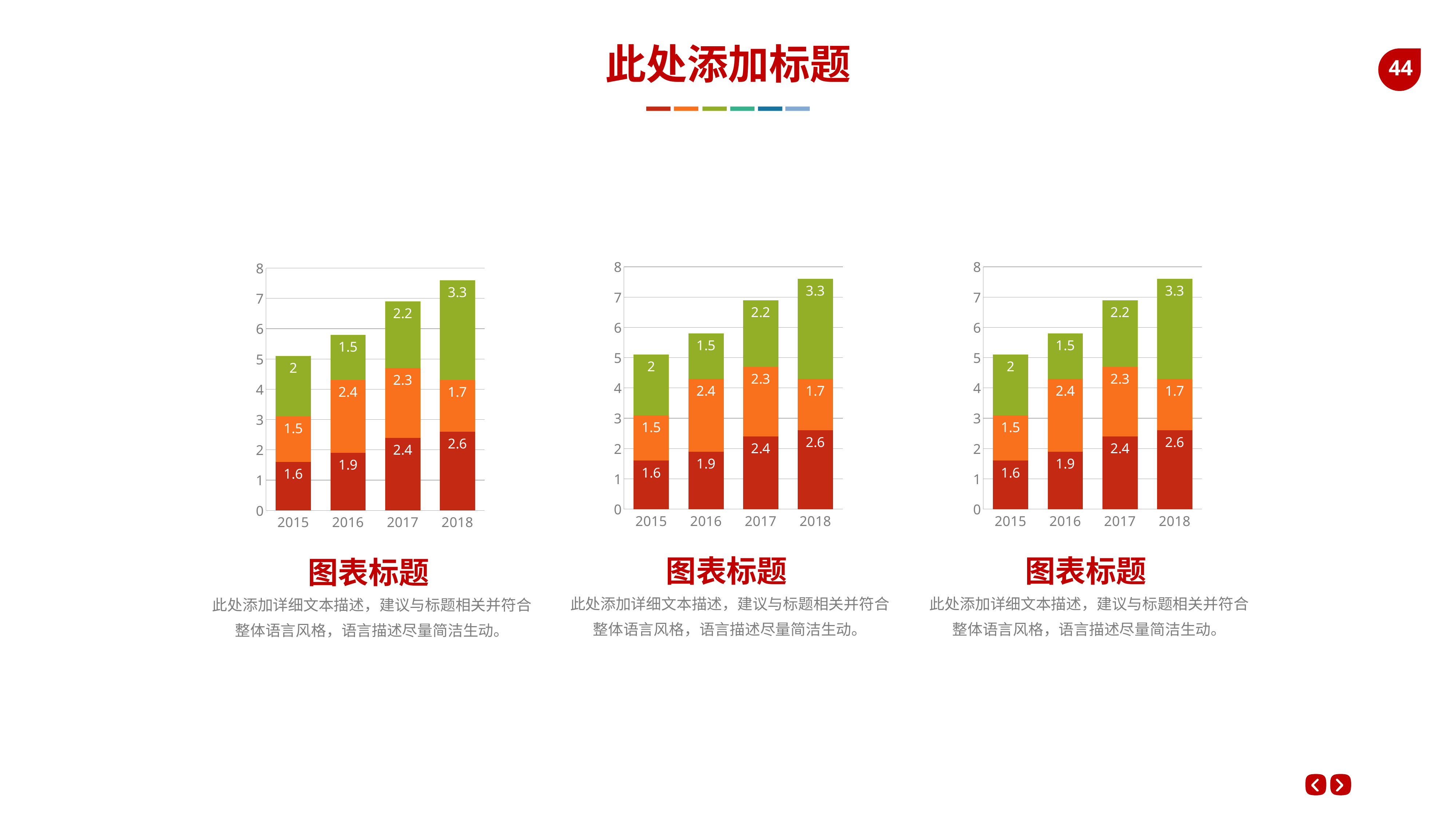
In the middle chart, what is the total of the stacked bar for 2015? 5.1 In the left chart, what is the value of the red (bottom) segment for 2015? 1.6 In the left chart, is the total height of the 2018 bar greater or less than 7? greater In the right chart, which year has the tallest stacked bar? 2018 In the left chart, which year has the shortest stacked bar? 2015 What type of chart is the right chart? Stacked bar chart In the middle chart, what is the difference between the green segment values for 2018 and 2015? 1.3 How many years are shown on the x axis of the middle chart? 4 In the middle chart, what is the value of the green (top) segment for 2018? 3.3 In the right chart, what is the value of the orange (middle) segment for 2016? 2.4 In the right chart, is the red segment for 2018 larger or smaller than the red segment for 2016? larger In the left chart, what is the total of the stacked bar for 2017? 6.9